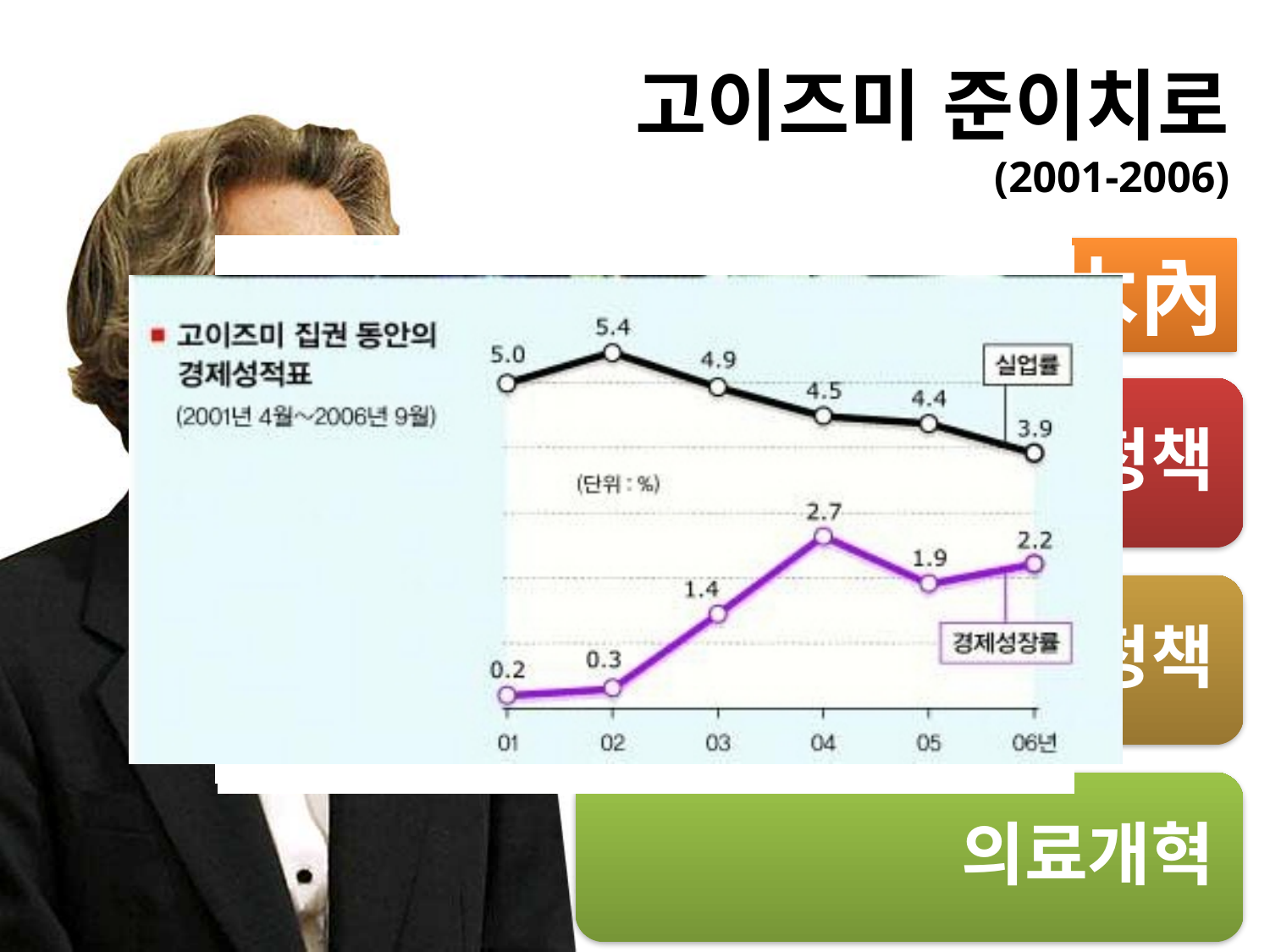
What type of chart is shown on the slide? line chart What is the difference between the 실업률 in 01 and in 06년? 1.1 What is the 실업률 value for 06년? 3.9 How many years are plotted on the x axis? 6 In which year is the 경제성장률 lowest? 01 Does the 실업률 rise or fall from 02 to 06년? fall What unit is shown for the values on the chart? % What is the 실업률 value for 02? 5.4 What is the 경제성장률 value for 04? 2.7 In which year is the 실업률 highest? 02 How many series are plotted on the chart? 2 Which is larger, the 경제성장률 in 04 or in 05? 04